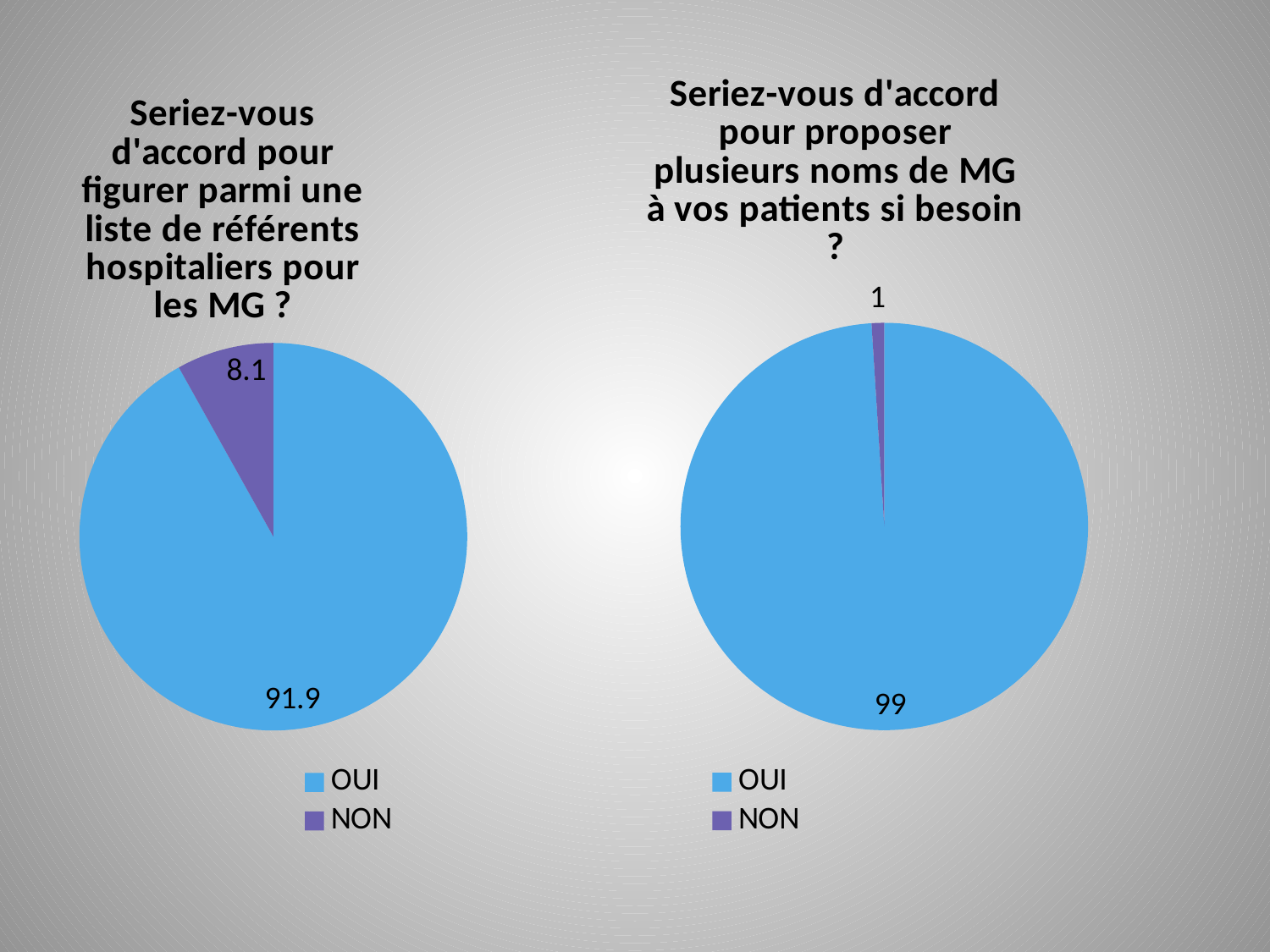
What type of chart is used on the left of the slide? Pie chart What colour is the NON slice in the right pie chart? Purple In the right pie chart ("Seriez-vous d'accord pour proposer plusieurs noms de MG à vos patients si besoin ?"), what is the value for NON? 1 In the right pie chart, what is the difference between the OUI and NON values? 98 In the left pie chart, which category has the largest slice? OUI In the right pie chart ("Seriez-vous d'accord pour proposer plusieurs noms de MG à vos patients si besoin ?"), what is the value for OUI? 99 In the right pie chart, which category has the smallest slice? NON Which is larger in the left pie chart: OUI or NON? OUI How many categories does the right pie chart show? 2 In the left pie chart ("Seriez-vous d'accord pour figurer parmi une liste de référents hospitaliers pour les MG ?"), what is the value for NON? 8.1 In the left pie chart, what is the difference between the OUI and NON values? 83.8 In the left pie chart ("Seriez-vous d'accord pour figurer parmi une liste de référents hospitaliers pour les MG ?"), what is the value for OUI? 91.9